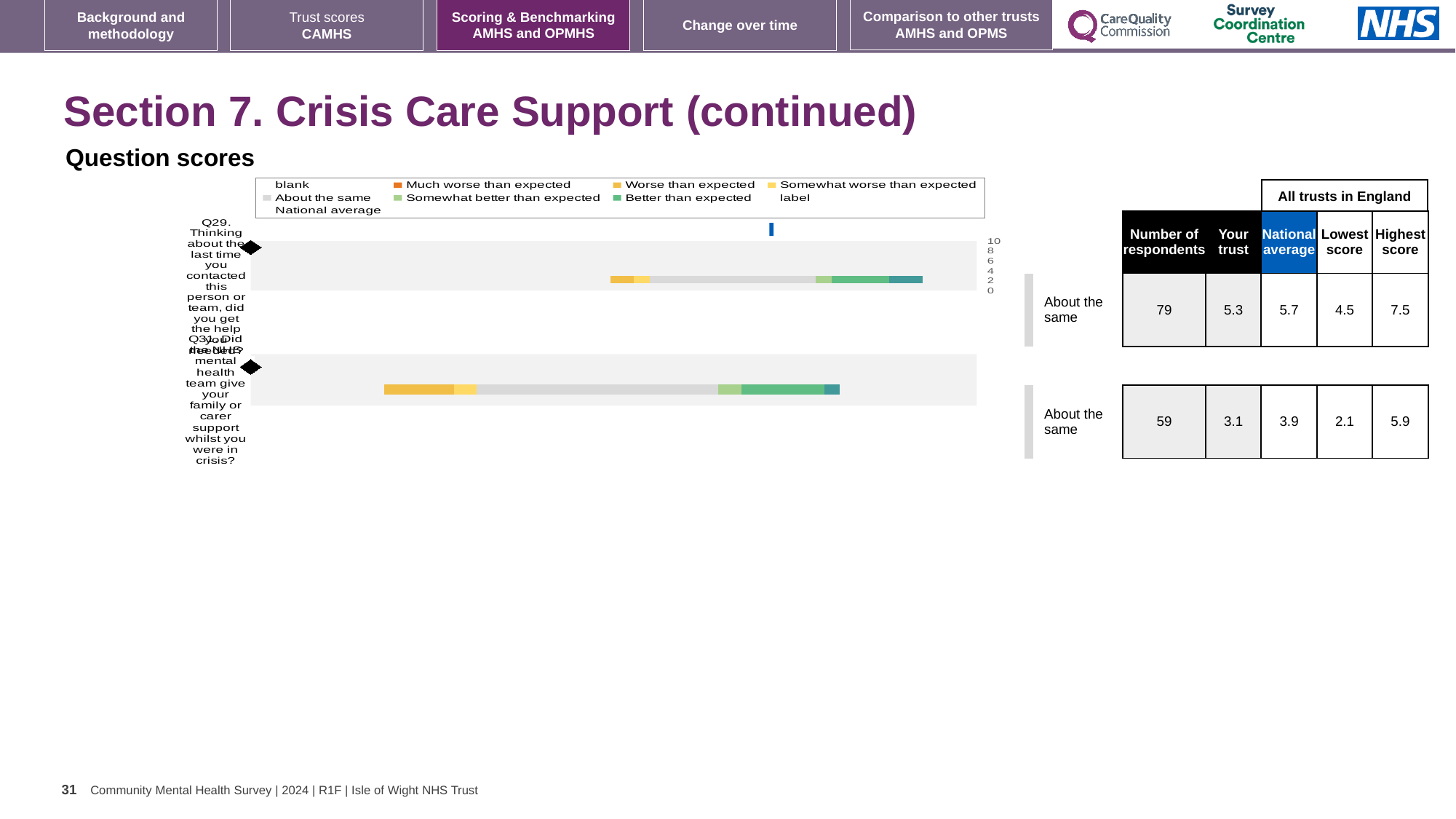
What is the 'Your trust' score for Q29 (did you get the help you needed the last time you contacted this person or team)? 5.3 What is the highest score among all trusts in England for Q31? 5.9 What is the 'Your trust' score for Q31? 3.1 What is the difference between the highest and lowest scores for Q31 across all trusts in England? 3.8 How many respondents answered Q31 (did the mental health team give your family or carer support whilst you were in crisis)? 59 What kind of chart is used to show the question scores on this slide? bar chart Which benchmark category is shown for both Q29 and Q31 next to the chart? About the same Which is higher for Q29: the 'Your trust' score or the national average? National average What is the difference between the national average and the 'Your trust' score for Q29? 0.4 How many questions (bars) are plotted in the question scores chart? 2 What is the national average score for Q29? 5.7 How many entries does the legend of the question scores chart list? 9